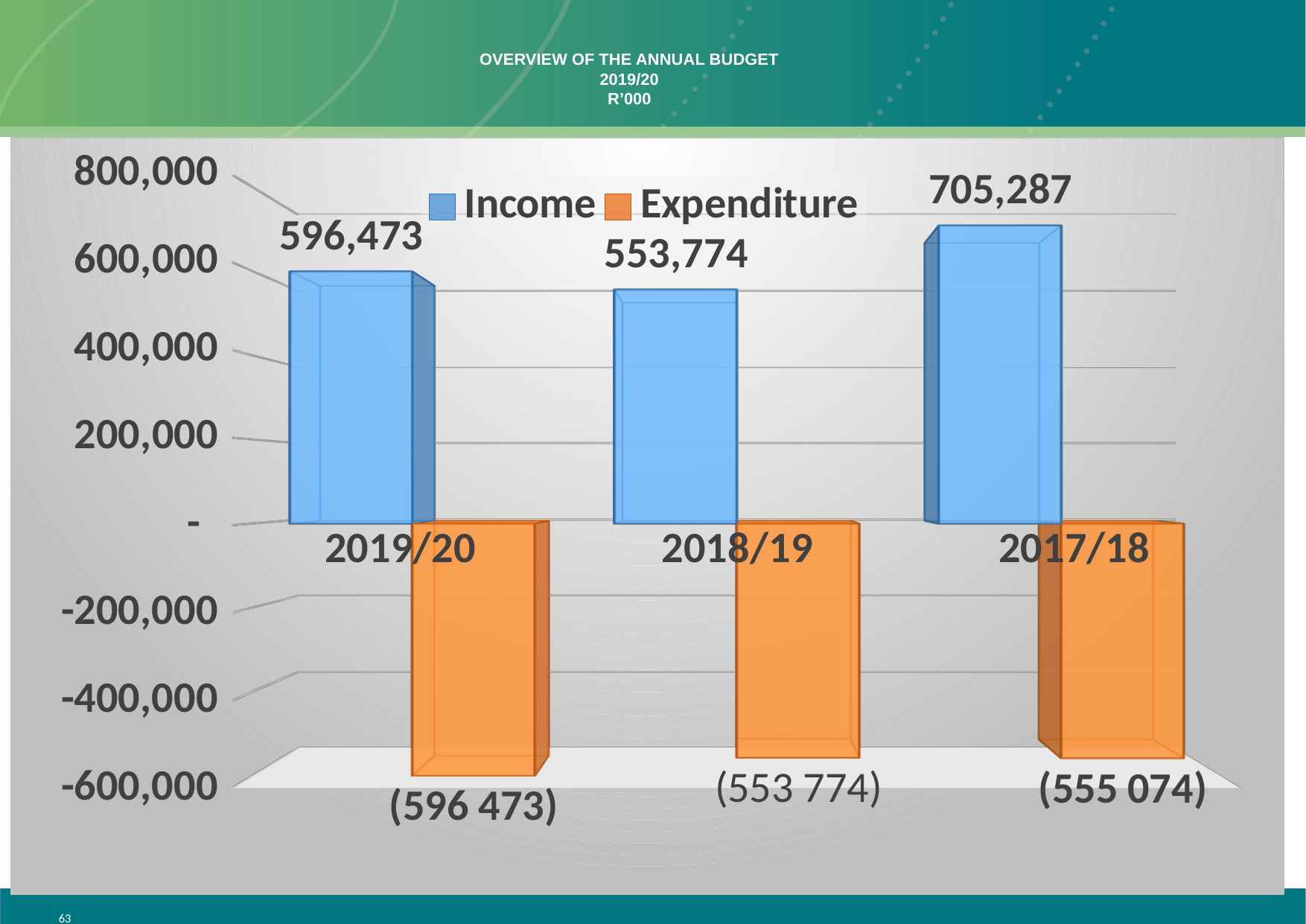
How many years are shown on the x axis? 3 Is the Income value for 2018/19 greater or less than 600,000? less What is the Income value for 2017/18? 705,287 What is the difference between the Income for 2017/18 and the Income for 2018/19? 151,513 How many series does the legend list? 2 Is the Income for 2019/20 larger or smaller than the Income for 2017/18? smaller Which year has the highest Income? 2017/18 What is the Expenditure data label shown for 2017/18? (555 074) What is the Income value for 2019/20? 596,473 What is the difference between the Income for 2019/20 and the Income for 2018/19? 42,699 Which year has the lowest Income? 2018/19 What is the Expenditure data label shown for 2018/19? (553 774)